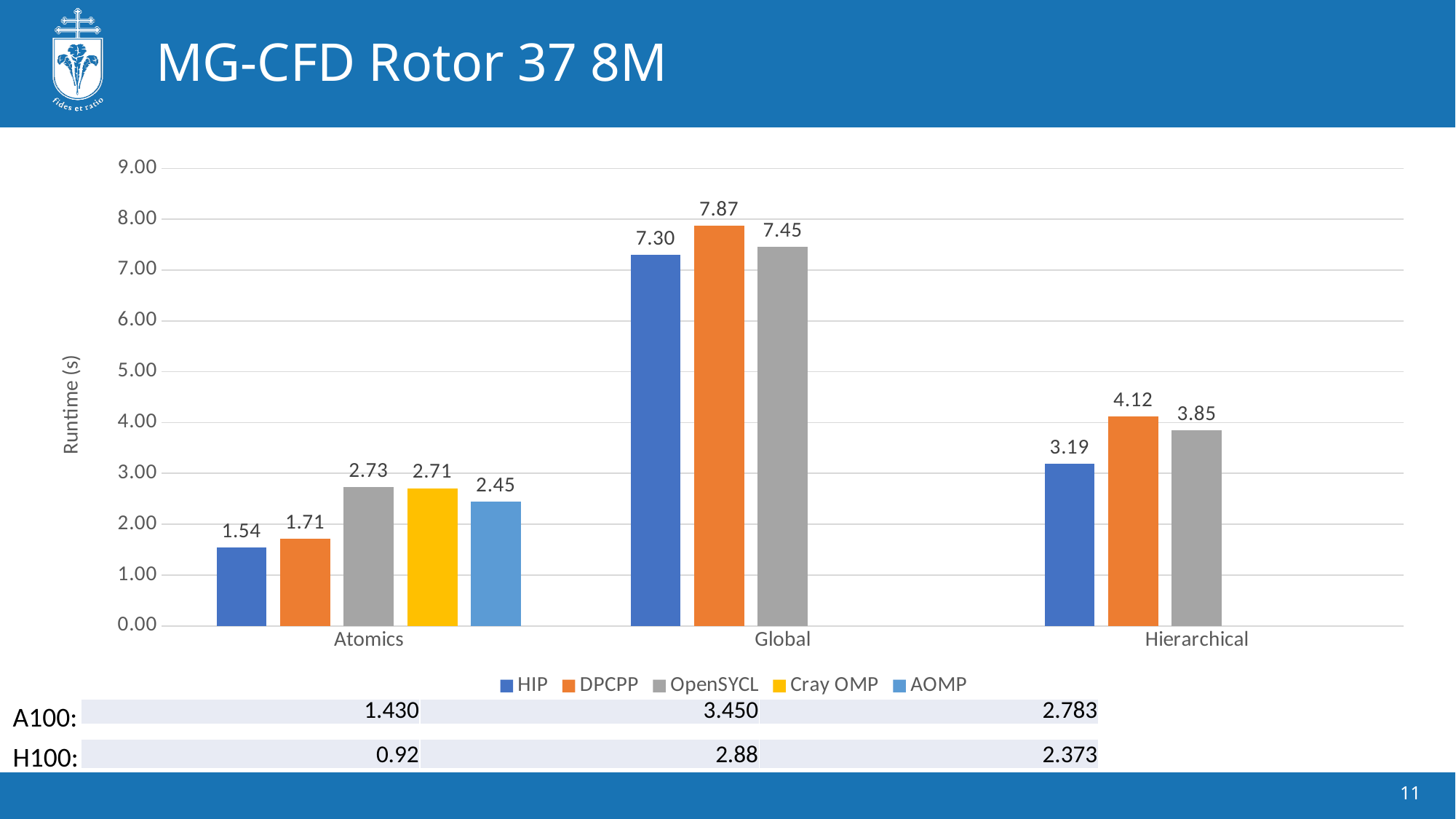
What is the difference between the DPCPP and HIP runtimes in the Hierarchical category? 0.93 How many series does the legend list? 5 What is the runtime for Cray OMP in the Atomics category? 2.71 How many categories are shown on the x axis? 3 What is the runtime for HIP in the Atomics category? 1.54 Which series has the highest runtime in the Global category? DPCPP What is the label of the y axis? Runtime (s) What kind of chart is shown on the slide? Bar chart Which series has the lowest runtime in the Atomics category? HIP What is the runtime for DPCPP in the Global category? 7.87 What is the runtime for OpenSYCL in the Hierarchical category? 3.85 Which is larger: the OpenSYCL runtime for Atomics or the AOMP runtime for Atomics? OpenSYCL